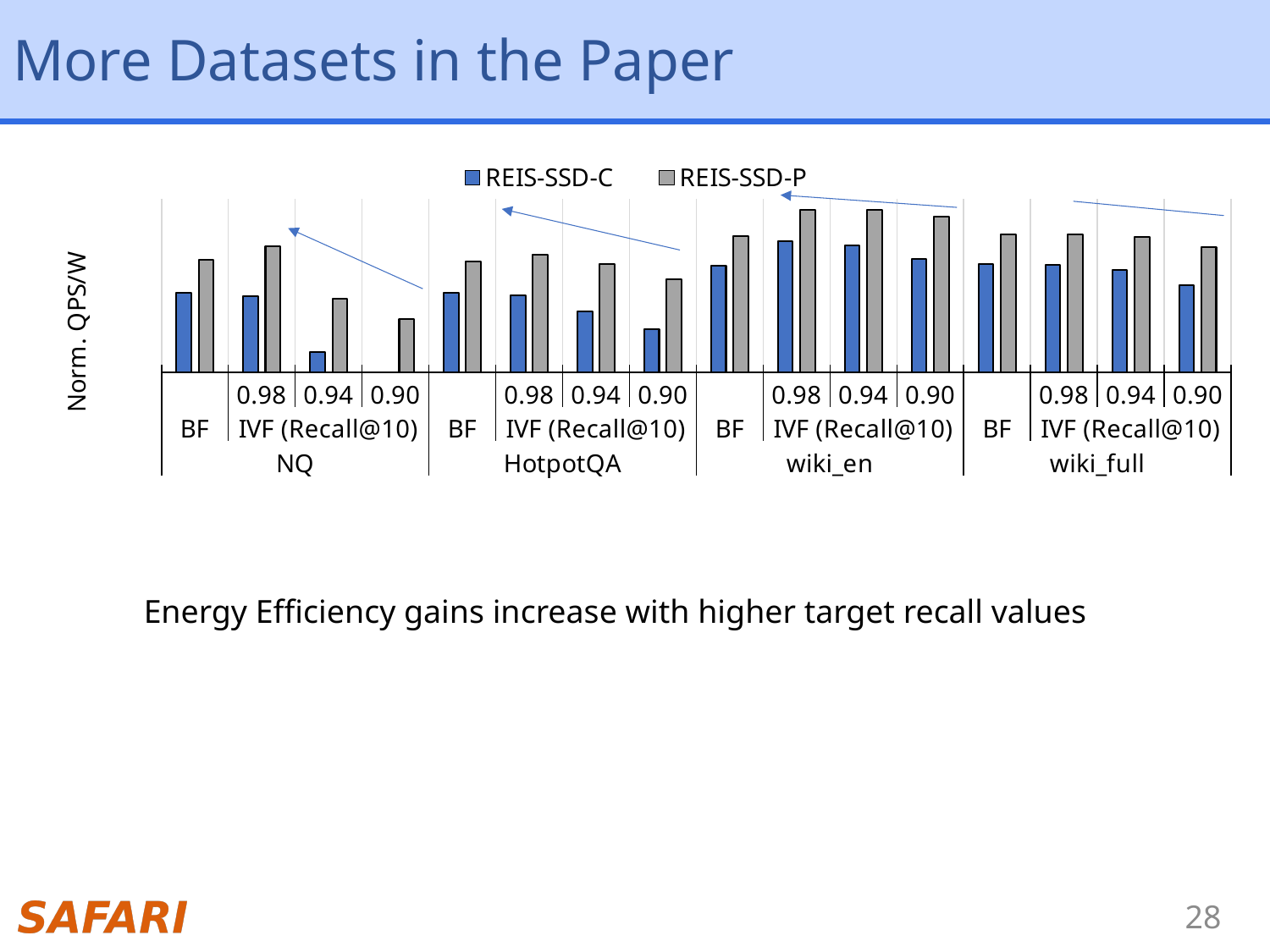
How many datasets are shown along the x axis of the chart? 4 Is the REIS-SSD-C value for NQ BF larger or smaller than the REIS-SSD-C value for NQ IVF at recall 0.94? larger Within the NQ group, which category has the tallest REIS-SSD-P bar? IVF (Recall@10) 0.98 What kind of chart is shown on the slide? bar chart What is the label on the vertical axis of the chart? Norm. QPS/W Is the REIS-SSD-C value for wiki_en BF larger or smaller than the REIS-SSD-C value for NQ BF? larger For HotpotQA IVF at recall 0.90, which series has the larger value, REIS-SSD-C or REIS-SSD-P? REIS-SSD-P For wiki_full, do the REIS-SSD-C bars rise or fall as the IVF recall target goes from 0.98 to 0.90? fall Which dataset group contains the tallest REIS-SSD-P bar in the chart? wiki_en How many series does the chart legend list? 2 What are the two series named in the chart legend? REIS-SSD-C and REIS-SSD-P